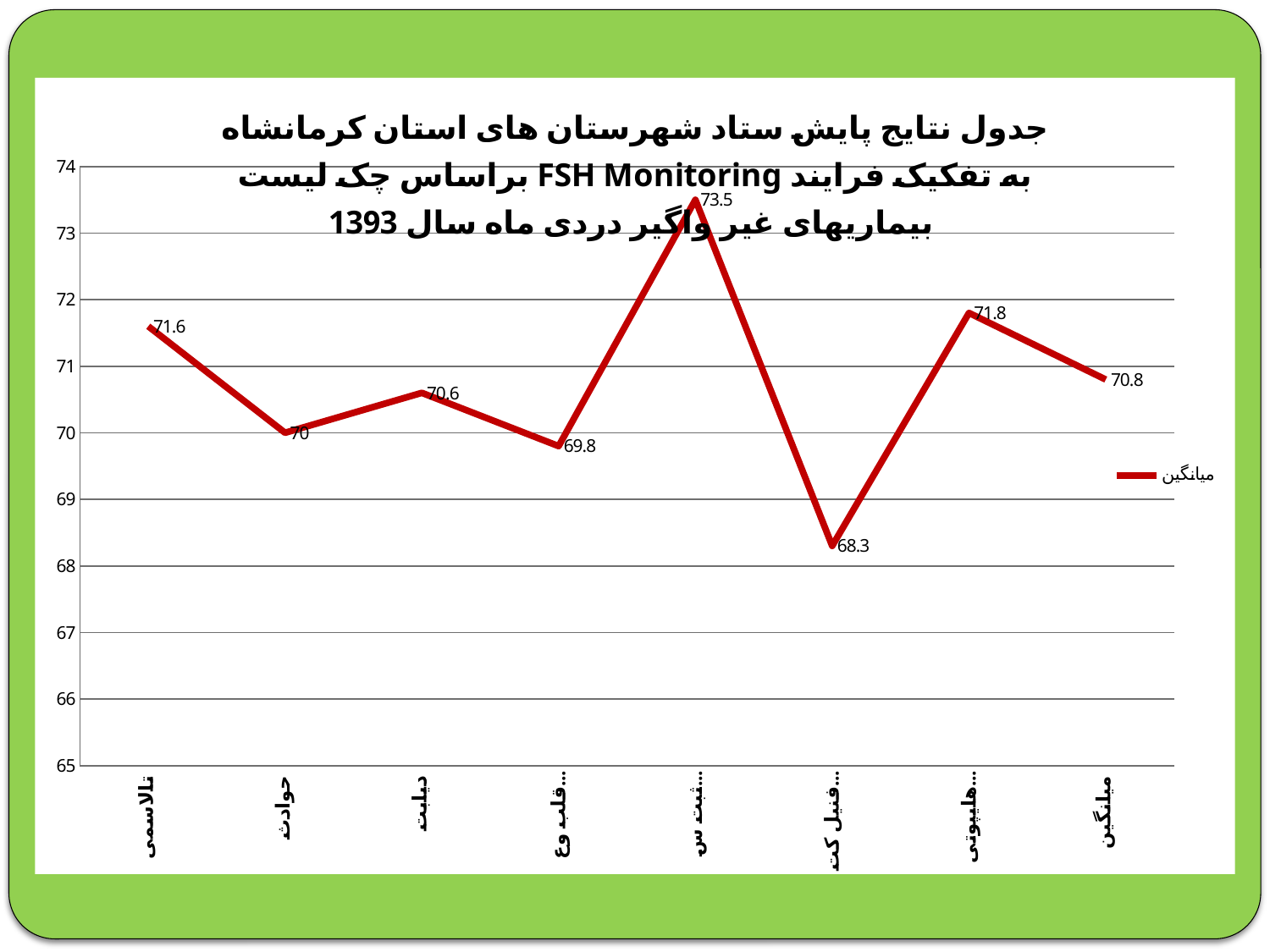
How many data points are plotted on the line? 8 What is the value for تالاسمی? 71.6 What is the value for the میانگین category on the x axis? 70.8 What is the value for حوادث? 70 How many series does the legend list? 1 What is the difference between the values for تالاسمی and حوادث? 1.6 What is the legend entry for the plotted line? میانگین What is the value for دیابت? 70.6 What is the highest value plotted on the line? 73.5 What type of chart is shown on the slide? line chart What is the lowest value plotted on the line? 68.3 Which is larger, the value for دیابت or the value for حوادث? دیابت